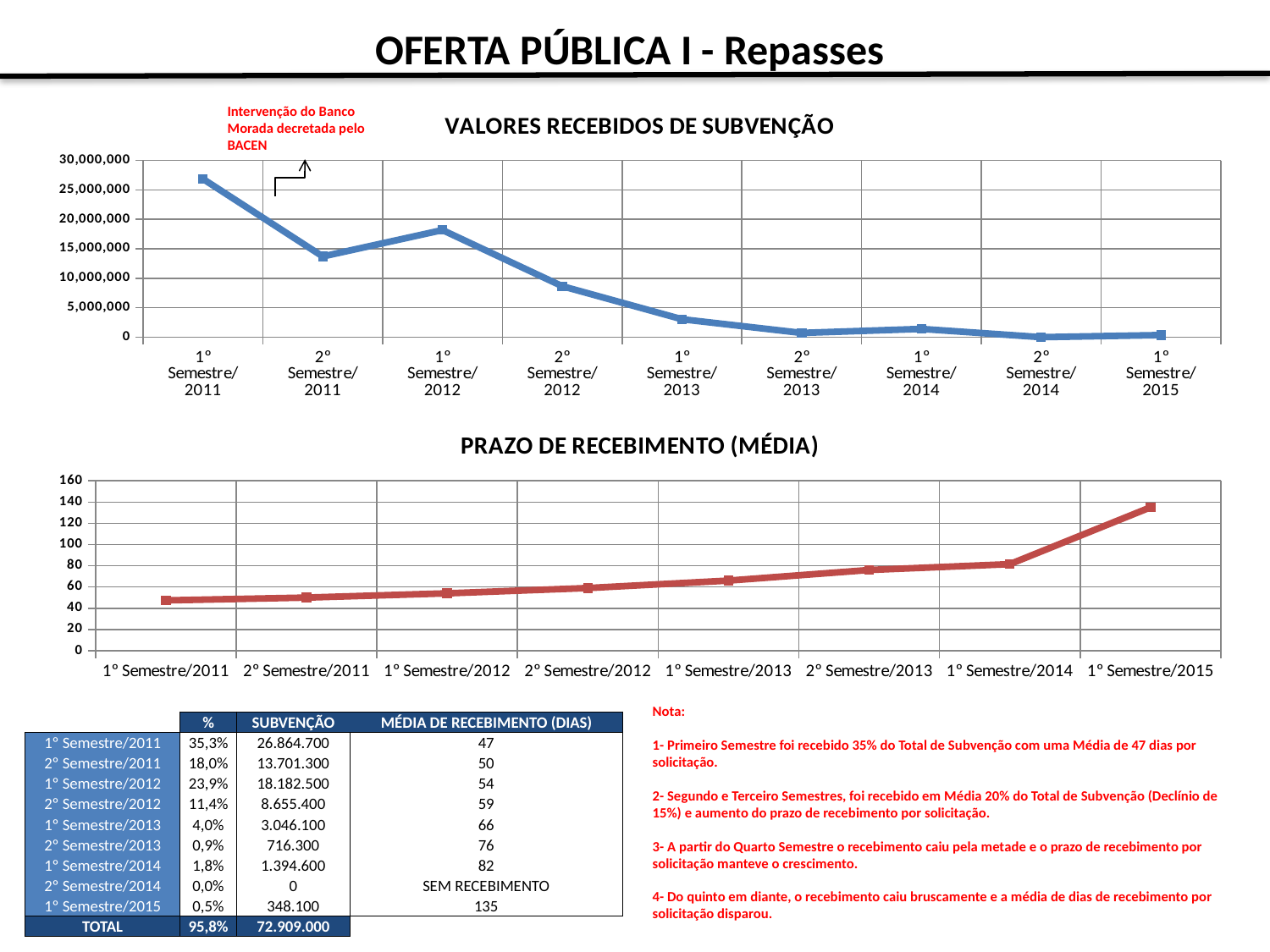
In the top chart "VALORES RECEBIDOS DE SUBVENÇÃO", how many data points are plotted? 9 In the bottom chart "PRAZO DE RECEBIMENTO (MÉDIA)", is the value for 1° Semestre/2015 greater or less than 120? greater In the top chart "VALORES RECEBIDOS DE SUBVENÇÃO", which semester has the highest value? 1° Semestre/2011 In the bottom chart "PRAZO DE RECEBIMENTO (MÉDIA)", do the values rise or fall from 1° Semestre/2011 to 1° Semestre/2015? Rise What kind of chart is the top chart titled "VALORES RECEBIDOS DE SUBVENÇÃO"? Line chart What does the red annotation above the top chart "VALORES RECEBIDOS DE SUBVENÇÃO" say? Intervenção do Banco Morada decretada pelo BACEN In the bottom chart "PRAZO DE RECEBIMENTO (MÉDIA)", how many data points are plotted? 8 In the top chart "VALORES RECEBIDOS DE SUBVENÇÃO", is the value for 1° Semestre/2011 greater or less than 25,000,000? greater In the bottom chart "PRAZO DE RECEBIMENTO (MÉDIA)", which semester has the highest value? 1° Semestre/2015 In the bottom chart "PRAZO DE RECEBIMENTO (MÉDIA)", is the value for 1° Semestre/2014 greater or less than 100? less In the top chart "VALORES RECEBIDOS DE SUBVENÇÃO", which is larger: the value for 2° Semestre/2011 or for 1° Semestre/2012? 1° Semestre/2012